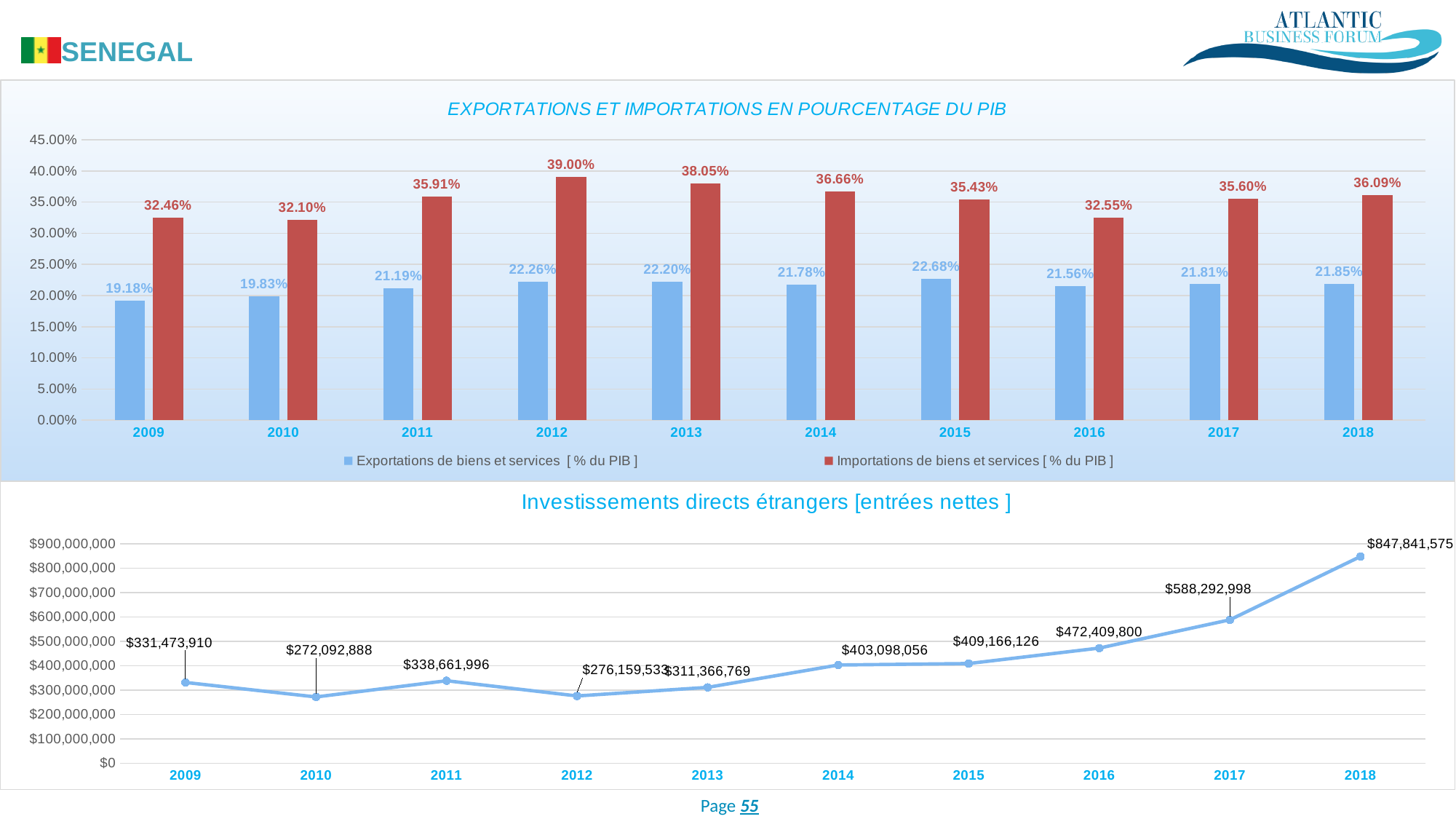
In the 'EXPORTATIONS ET IMPORTATIONS EN POURCENTAGE DU PIB' chart, what is the value of Importations de biens et services for 2012? 39.00% In the 'Investissements directs étrangers [entrées nettes ]' chart, how many years are plotted? 10 In the 'EXPORTATIONS ET IMPORTATIONS EN POURCENTAGE DU PIB' chart, which year has the highest value for Exportations de biens et services? 2015 What kind of chart is the 'Investissements directs étrangers [entrées nettes ]' chart? Line chart In the 'Investissements directs étrangers [entrées nettes ]' chart, which year has the lowest value? 2010 In the 'Investissements directs étrangers [entrées nettes ]' chart, is the value for 2017 larger than the value for 2016? Yes In the 'EXPORTATIONS ET IMPORTATIONS EN POURCENTAGE DU PIB' chart, what is the value of Exportations de biens et services for 2009? 19.18% In the 'EXPORTATIONS ET IMPORTATIONS EN POURCENTAGE DU PIB' chart, how many series does the legend list? 2 In the 'EXPORTATIONS ET IMPORTATIONS EN POURCENTAGE DU PIB' chart, what is the difference between Importations and Exportations in 2018? 14.24% In the 'EXPORTATIONS ET IMPORTATIONS EN POURCENTAGE DU PIB' chart, which year has the lowest value for Importations de biens et services? 2010 What kind of chart is the 'EXPORTATIONS ET IMPORTATIONS EN POURCENTAGE DU PIB' chart? Bar chart In the 'Investissements directs étrangers [entrées nettes ]' chart, what is the value for 2018? $847,841,575